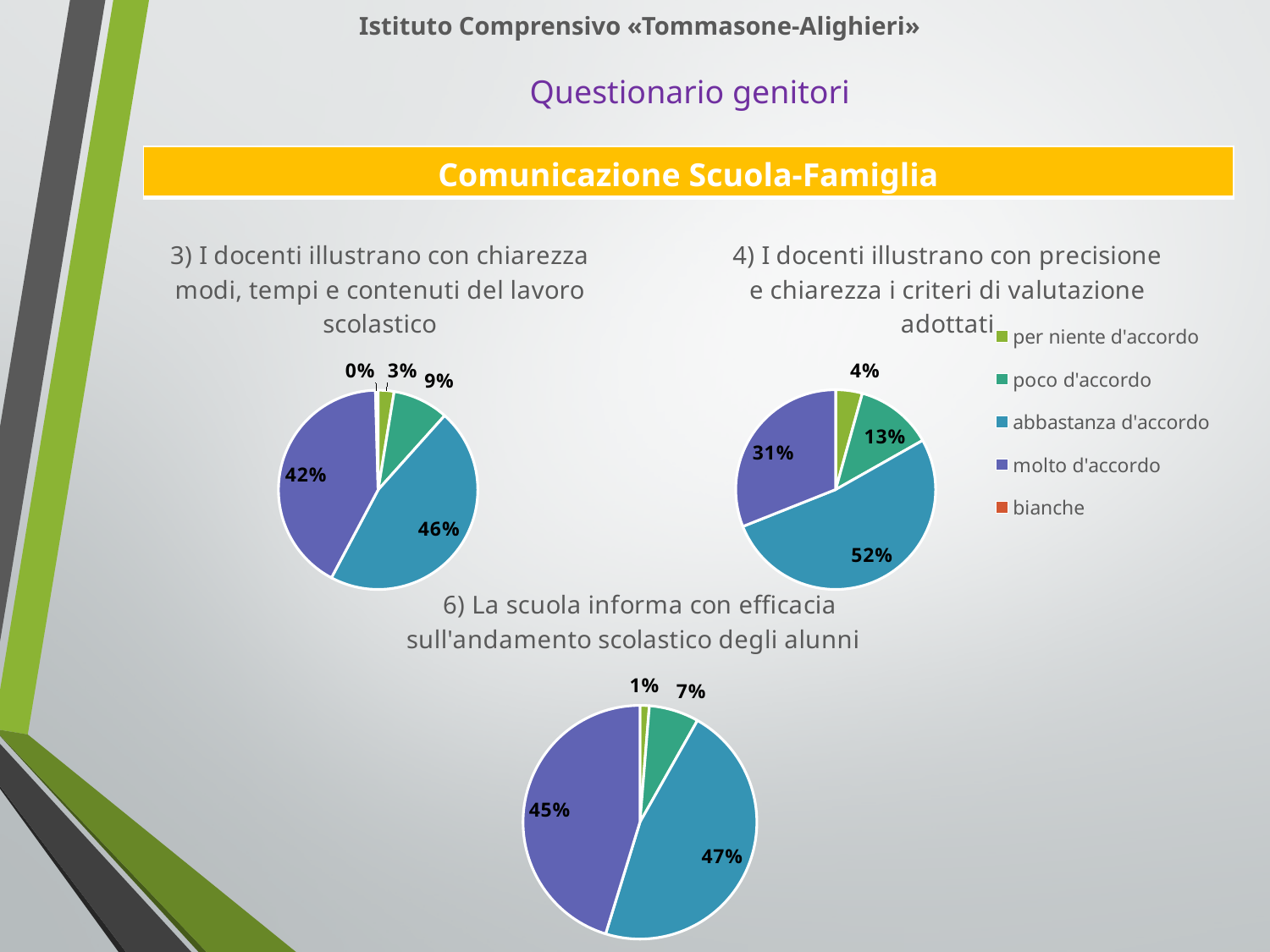
In the chart for question 4 (I docenti illustrano con precisione e chiarezza i criteri di valutazione adottati), what share is 'abbastanza d'accordo'? 52% In the chart for question 4, which category has the largest share? abbastanza d'accordo How many entries does the shared legend list? 5 In the chart for question 4, which is larger: 'poco d'accordo' or 'molto d'accordo'? molto d'accordo In the chart for question 6, what is the difference between the 'abbastanza d'accordo' and 'molto d'accordo' shares? 2% In the chart for question 6 (La scuola informa con efficacia sull'andamento scolastico degli alunni), what share is 'molto d'accordo'? 45% In the chart for question 3 (I docenti illustrano con chiarezza modi, tempi e contenuti del lavoro scolastico), what share is 'abbastanza d'accordo'? 46% In the chart for question 3, what share is 'molto d'accordo'? 42% What type of chart is used for question 6? pie chart In the chart for question 6, what share is 'per niente d'accordo'? 1% In the chart for question 3, what share is 'poco d'accordo'? 9% In the chart for question 4, what share is 'per niente d'accordo'? 4%